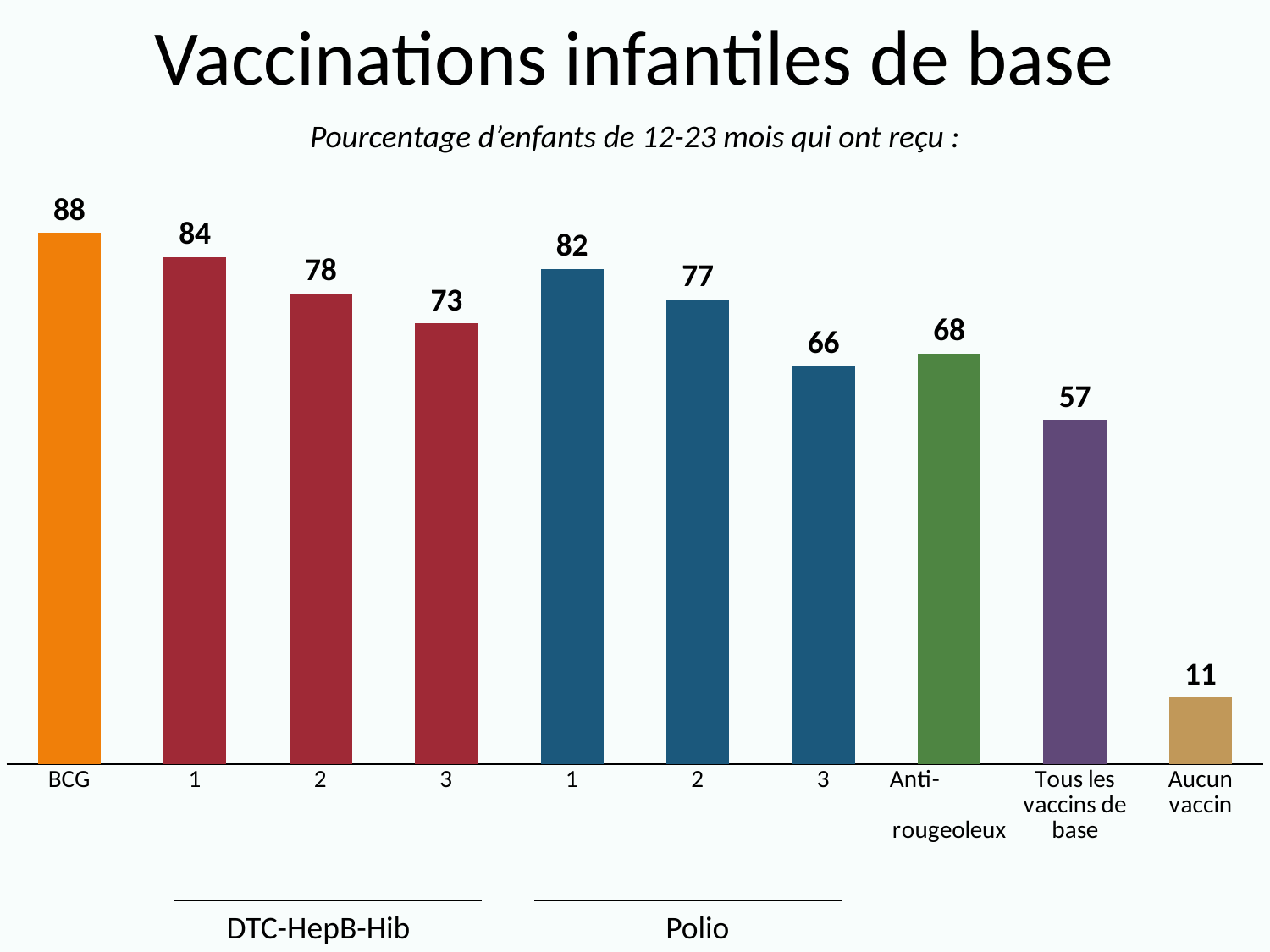
What is the value for Tous les vaccins de base? 57 Which category has the highest value? BCG How many bars are shown in the chart? 10 What is the title of the chart? Vaccinations infantiles de base What is the value for Anti-rougeoleux? 68 What is the difference between the first dose of DTC-HepB-Hib and the third dose of DTC-HepB-Hib? 11 What is the value for the second dose of Polio? 77 What is the value for BCG? 88 Which is larger, the first dose of Polio or the first dose of DTC-HepB-Hib? the first dose of DTC-HepB-Hib Which category has the lowest value? Aucun vaccin What kind of chart is shown on the slide? bar chart What is the value for the third dose of DTC-HepB-Hib? 73